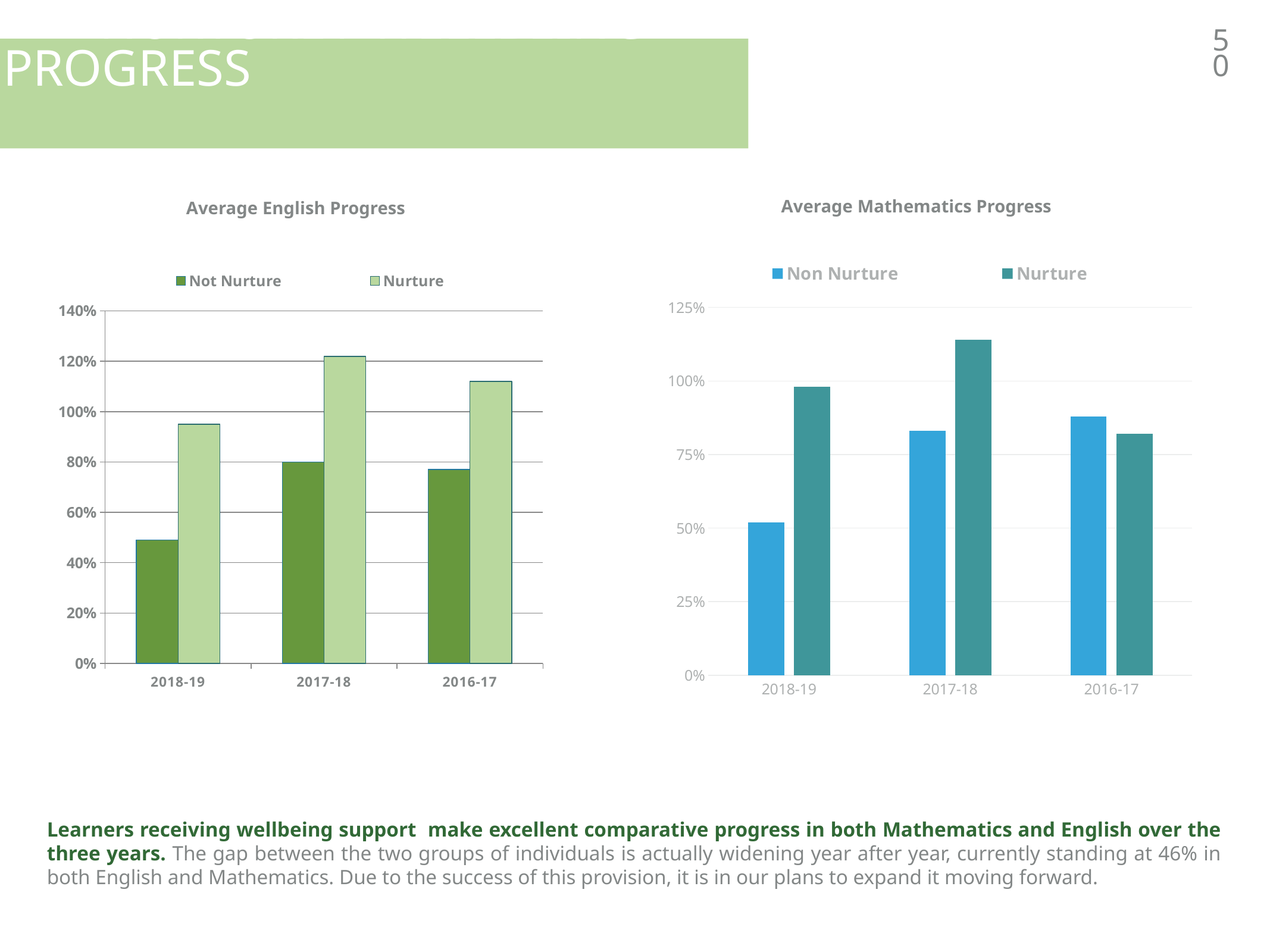
In the Average English Progress chart, is the Nurture value for 2018-19 greater or less than 100%? less In the Average English Progress chart, which year has the highest Nurture value? 2017-18 In the Average English Progress chart, is the Nurture value for 2017-18 greater or less than 100%? greater How many series does the legend of the Average Mathematics Progress chart list? 2 In the Average Mathematics Progress chart, is the Nurture value for 2017-18 greater or less than 100%? greater How many year categories are shown on the x axis of the Average English Progress chart? 3 In the Average Mathematics Progress chart, which is larger for 2018-19, Non Nurture or Nurture? Nurture What are the two legend entries of the Average English Progress chart? Not Nurture and Nurture In the Average English Progress chart, which year has the lowest Not Nurture value? 2018-19 What type of chart is the Average English Progress chart? bar chart